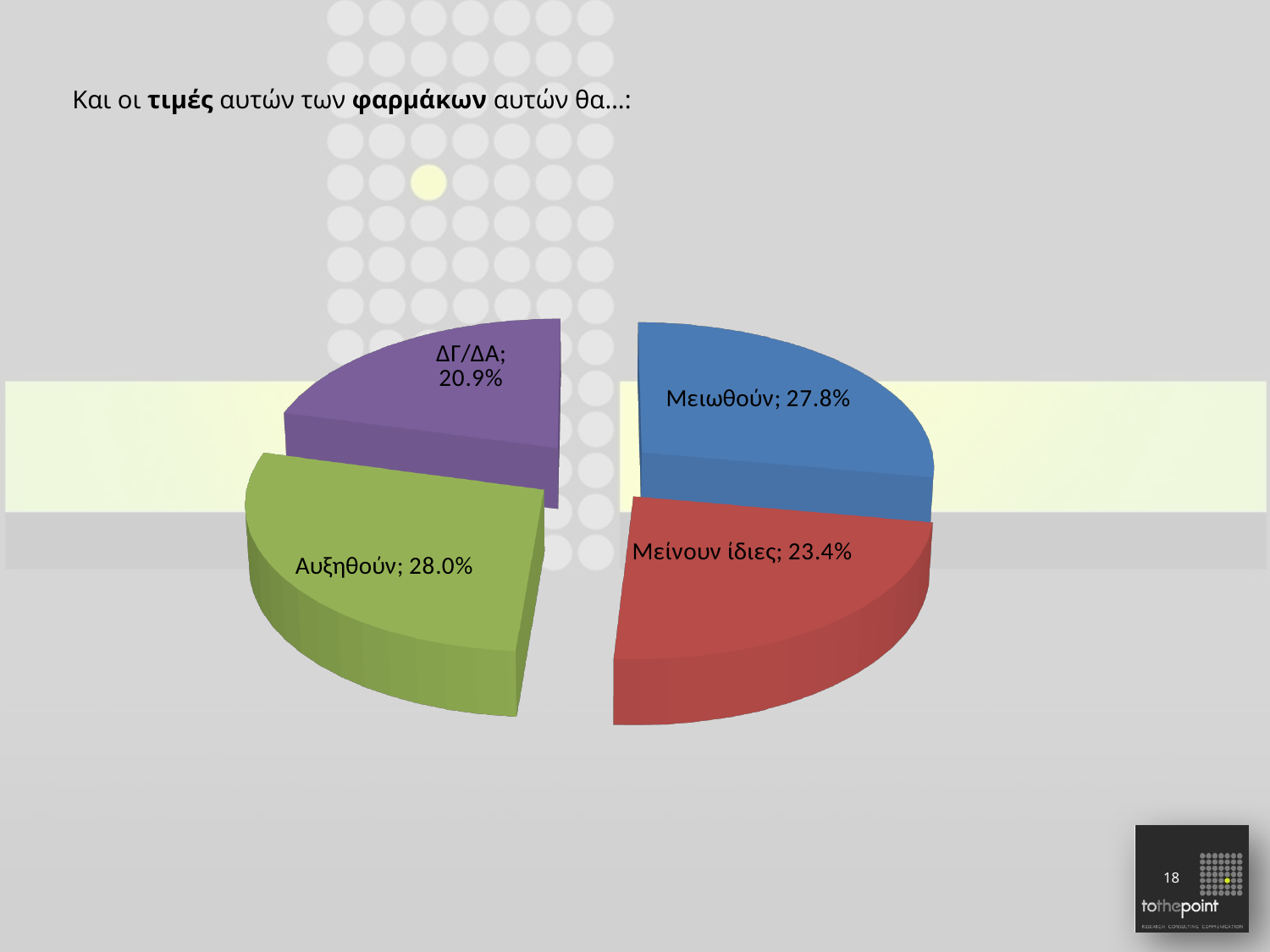
What percentage is shown for the slice labelled Μείνουν ίδιες? 23.4% What colour is the slice labelled Μείνουν ίδιες? red What kind of chart is shown on the slide? pie chart What is the difference in percentage points between the Αυξηθούν slice and the ΔΓ/ΔΑ slice? 7.1 What is the difference in percentage points between the Μειωθούν slice and the Μείνουν ίδιες slice? 4.4 Which slice of the pie chart has the smallest share? ΔΓ/ΔΑ How many slices does the pie chart have? 4 What percentage is shown for the slice labelled ΔΓ/ΔΑ? 20.9% Which is larger, the share for Μειωθούν or the share for Μείνουν ίδιες? Μειωθούν Which slice of the pie chart has the largest share? Αυξηθούν What percentage is shown for the slice labelled Μειωθούν? 27.8% What percentage is shown for the slice labelled Αυξηθούν? 28.0%